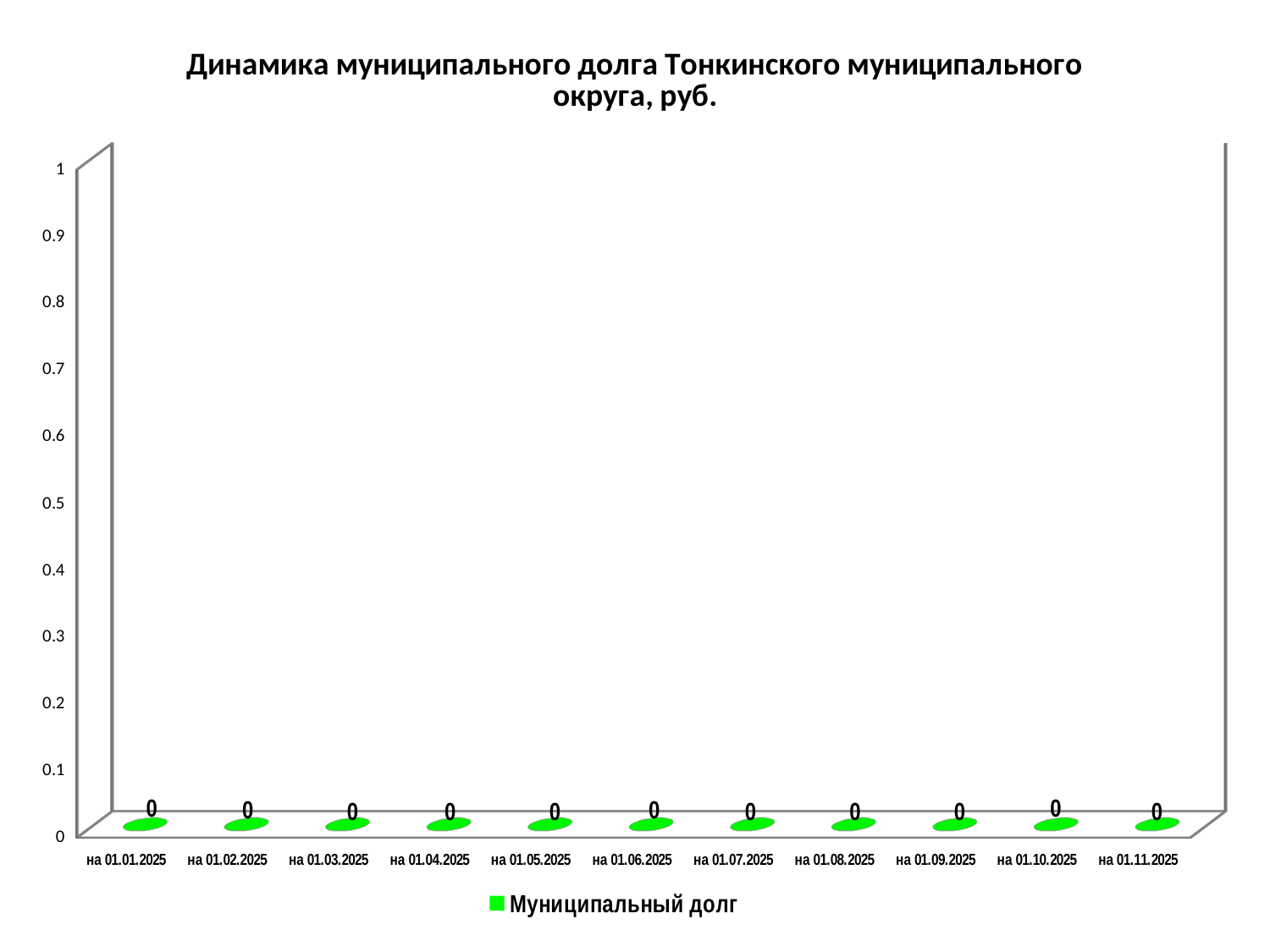
Is the value for на 01.07.2025 greater or less than 0.5? less Do the values rise, fall, or stay the same from на 01.01.2025 to на 01.11.2025? stay the same What kind of chart is this? bar chart What is the value for на 01.01.2025? 0 What is the title of the chart? Динамика муниципального долга Тонкинского муниципального округа, руб. What is the value for на 01.06.2025? 0 How many categories (dates) are shown on the x axis? 11 How many series does the legend list? 1 What is the difference between the values for на 01.03.2025 and на 01.09.2025? 0 What is the name of the series shown in the legend? Муниципальный долг What is the value for на 01.11.2025? 0